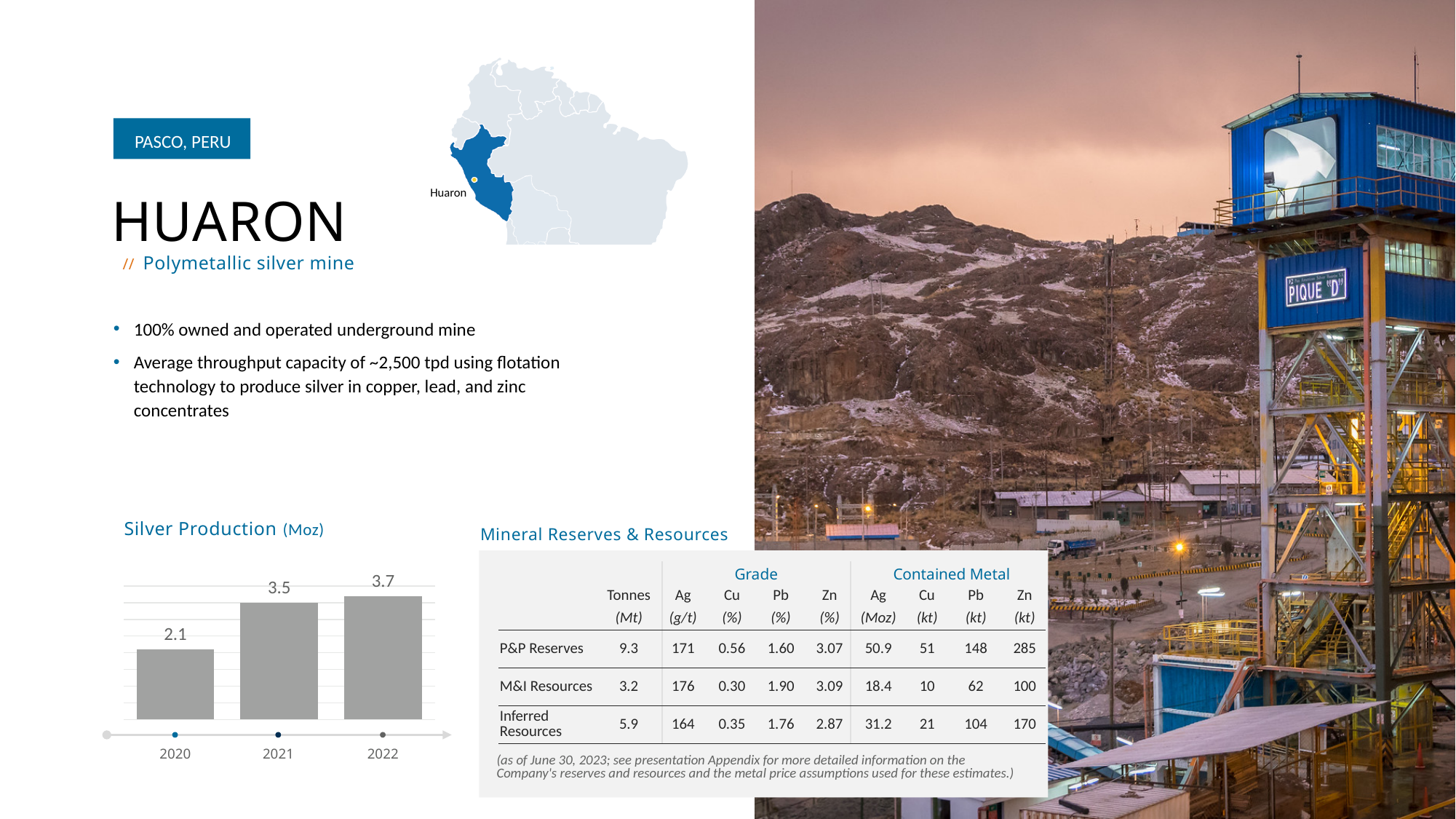
Which year has the lowest silver production in the chart? 2020 Does silver production rise or fall from 2020 to 2022 in the chart? Rise What is the difference in silver production between 2022 and 2020? 1.6 What unit is silver production measured in according to the chart title? Moz What was silver production in 2020 according to the Silver Production chart? 2.1 How many years are shown in the Silver Production chart? 3 Which year has the highest silver production in the chart? 2022 Which year had higher silver production, 2020 or 2021? 2021 What type of chart is the Silver Production chart? Bar chart What was silver production in 2021 according to the Silver Production chart? 3.5 What is the difference in silver production between 2021 and 2020? 1.4 What was silver production in 2022 according to the Silver Production chart? 3.7